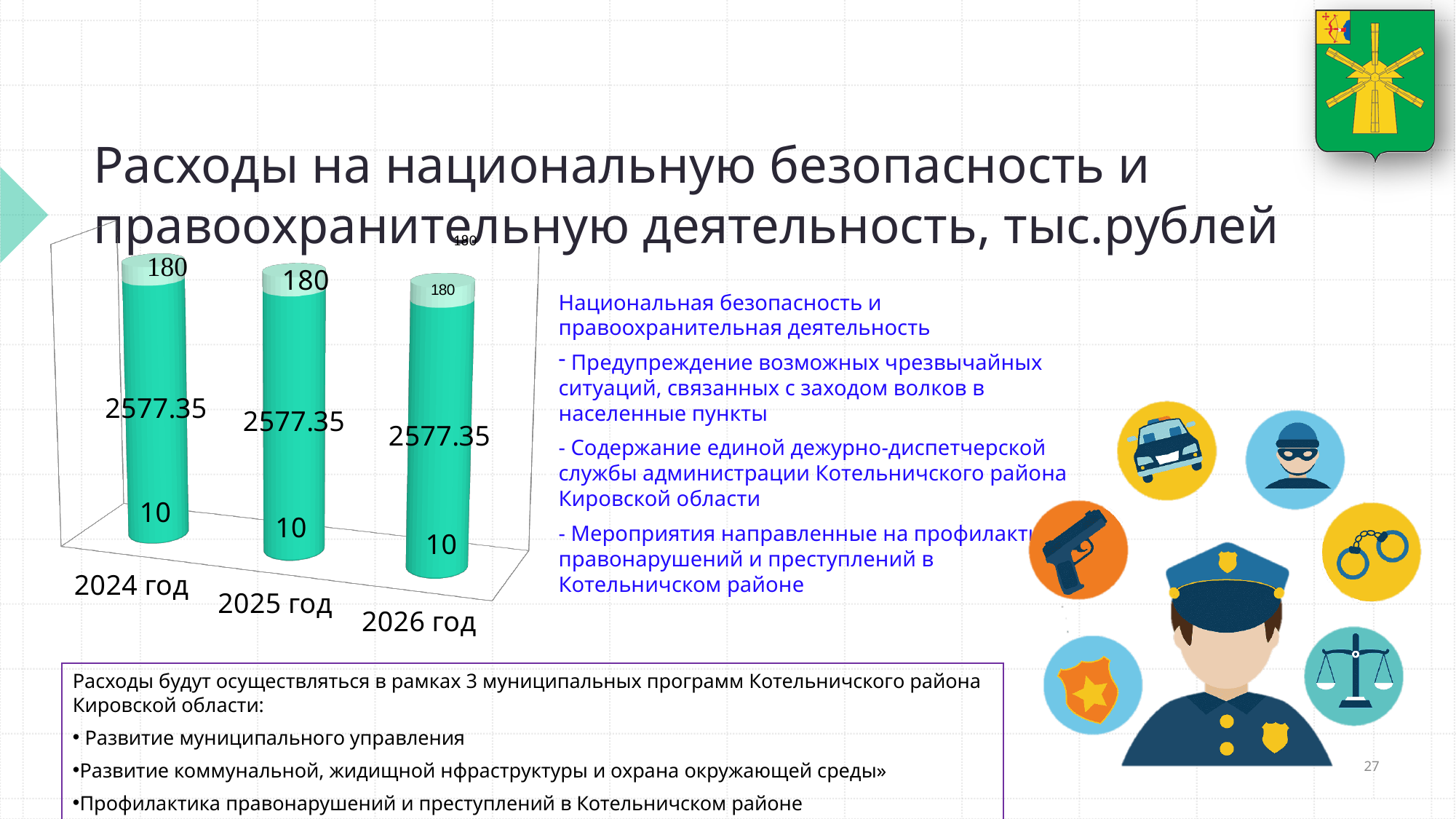
What is the value of the middle segment of the bar for 2026 год? 2577.35 What is the value of the bottom segment of the bar for 2026 год? 10 What is the total of the stacked bar for 2026 год? 2767.35 What is the title of the chart on the slide? Расходы на национальную безопасность и правоохранительную деятельность, тыс.рублей What kind of chart is shown on the slide? Stacked bar chart Which segment of the bar for 2024 год is larger: the top segment or the bottom segment? The top segment (180) How many categories (years) are shown on the x axis of the chart? 3 What is the total of the stacked bar for 2024 год? 2767.35 What is the value of the middle (largest) segment of the bar for 2024 год? 2577.35 Do the values of the middle segment rise, fall or stay the same from 2024 год to 2026 год? Stay the same What is the value of the top segment of the bar for 2025 год? 180 What is the difference between the top segment (180) and the bottom segment (10) of the bar for 2025 год? 170